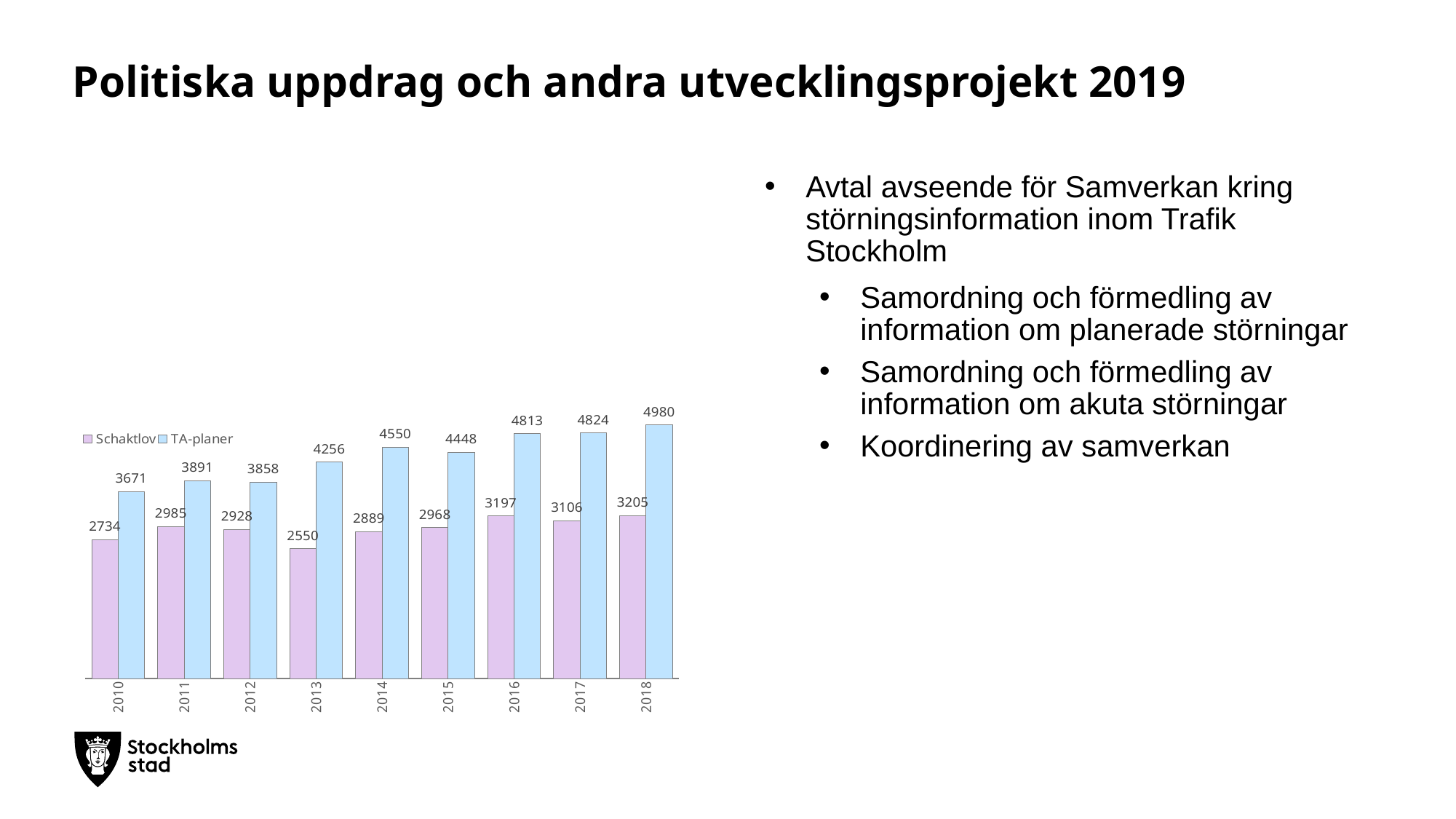
How many years are shown on the x axis? 9 What are the two series named in the chart legend? Schaktlov and TA-planer What is the value for Schaktlov in 2010? 2734 Which year has the highest value for TA-planer? 2018 What is the value for TA-planer in 2013? 4256 Which year has the lowest value for Schaktlov? 2013 Does the value for TA-planer generally rise or fall from 2010 to 2018? Rise Which is larger in 2016: Schaktlov or TA-planer? TA-planer How many series does the legend list? 2 What kind of chart is shown on the slide? Bar chart What is the value for TA-planer in 2018? 4980 What is the difference between TA-planer and Schaktlov in 2018? 1775